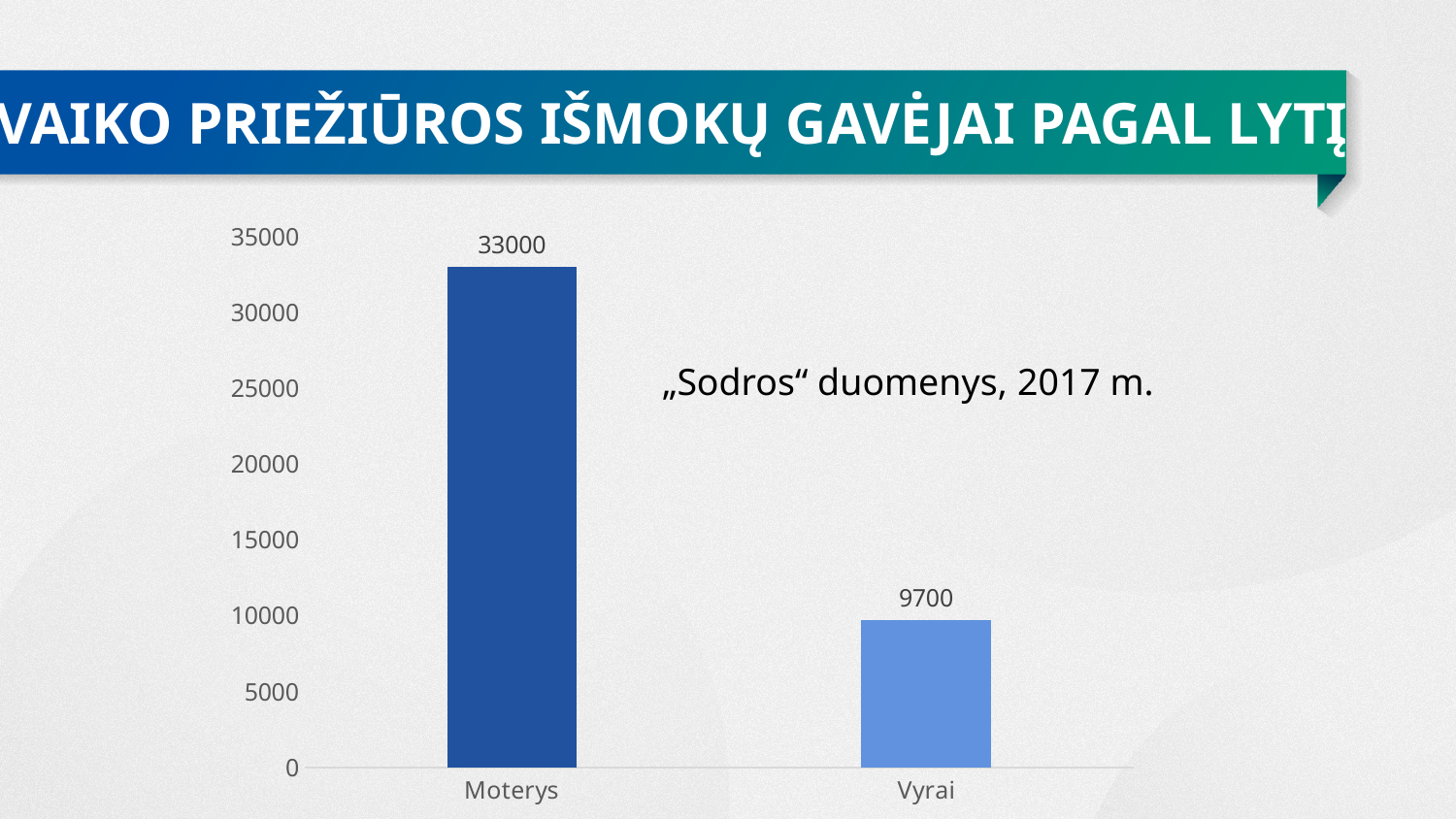
Is the value for Moterys greater or less than 30000? greater What is the value for Moterys? 33000 What is the difference between the values for Moterys and Vyrai? 23300 What is the source and year of the data noted next to the chart? „Sodros“ duomenys, 2017 m. How many categories are shown on the x axis? 2 What is the value for Vyrai? 9700 Which category has the highest value? Moterys Which category has the lowest value? Vyrai Which is larger, the value for Moterys or the value for Vyrai? Moterys What is the highest value shown on the vertical axis? 35000 Is the value for Vyrai greater or less than 10000? less What kind of chart is shown on the slide? bar chart